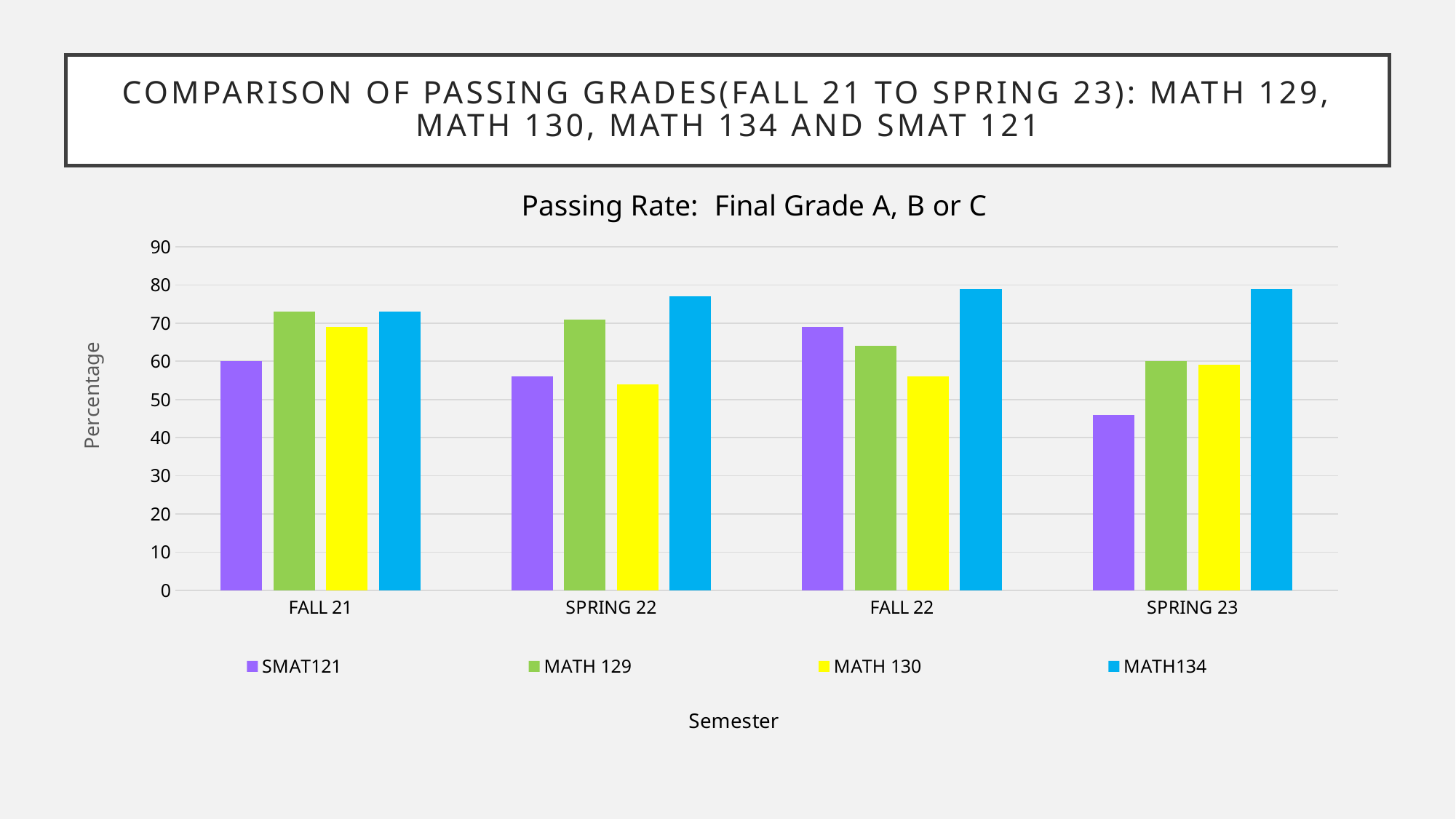
How many series does the legend list? 4 How many semesters are shown on the x axis? 4 Which course has the highest passing rate in SPRING 23? MATH134 Which course has the lowest passing rate in SPRING 23? SMAT121 Does the passing rate for MATH134 rise or fall from FALL 21 to FALL 22? rise Is the value for MATH 130 in SPRING 22 greater or less than 60? less In FALL 22, which is larger: the passing rate for SMAT121 or for MATH 129? SMAT121 Which course has the lowest passing rate in FALL 21? SMAT121 Is the value for SMAT121 in SPRING 23 greater or less than 50? less Is the value for MATH134 in FALL 22 greater or less than 70? greater What kind of chart is shown on the slide? bar chart What is the title of the chart? Passing Rate: Final Grade A, B or C